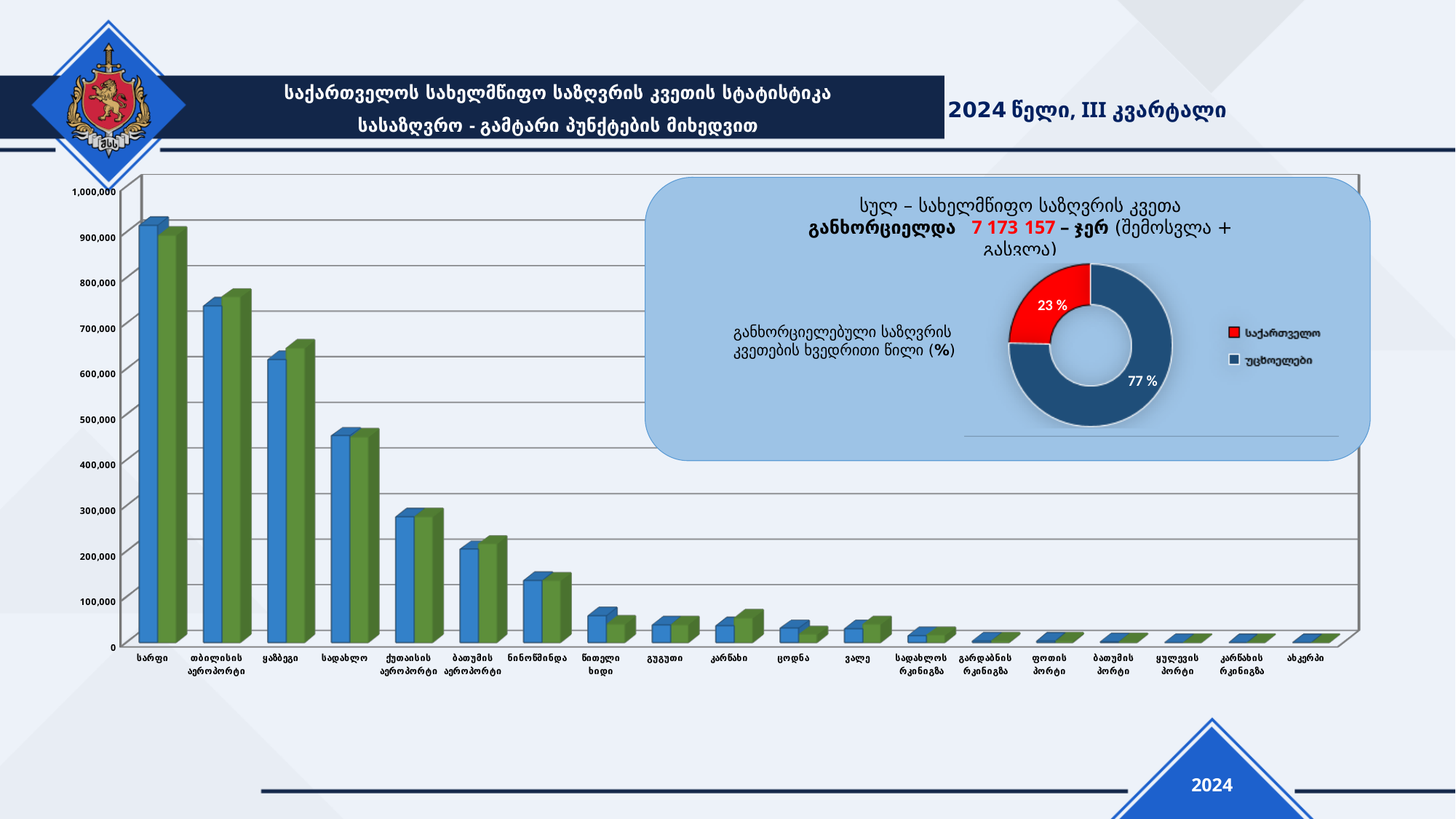
In the bar chart on the left, do the values rise or fall moving from left to right along the x axis? fall In the bar chart on the left, is the value for ქუთაისის აეროპორტი greater or less than 300,000? less In the doughnut chart on the right, how many entries does the legend list? 2 In the doughnut chart on the right, which slice is larger, საქართველო or უცხოელები? უცხოელები What kind of chart is the large chart on the left of the slide? bar chart In the bar chart on the left, is the value for სადახლო greater or less than 500,000? less In the doughnut chart on the right, what share is shown for საქართველო? 23 % In the doughnut chart on the right, what share is shown for უცხოელები? 77 % In the bar chart on the left, how many categories are shown on the x axis? 19 In the bar chart on the left, which has the larger value, ყაზბეგი or სადახლო? ყაზბეგი In the bar chart on the left, which category has the highest value? სარფი In the bar chart on the left, is the value for თბილისის აეროპორტი greater or less than 700,000? greater